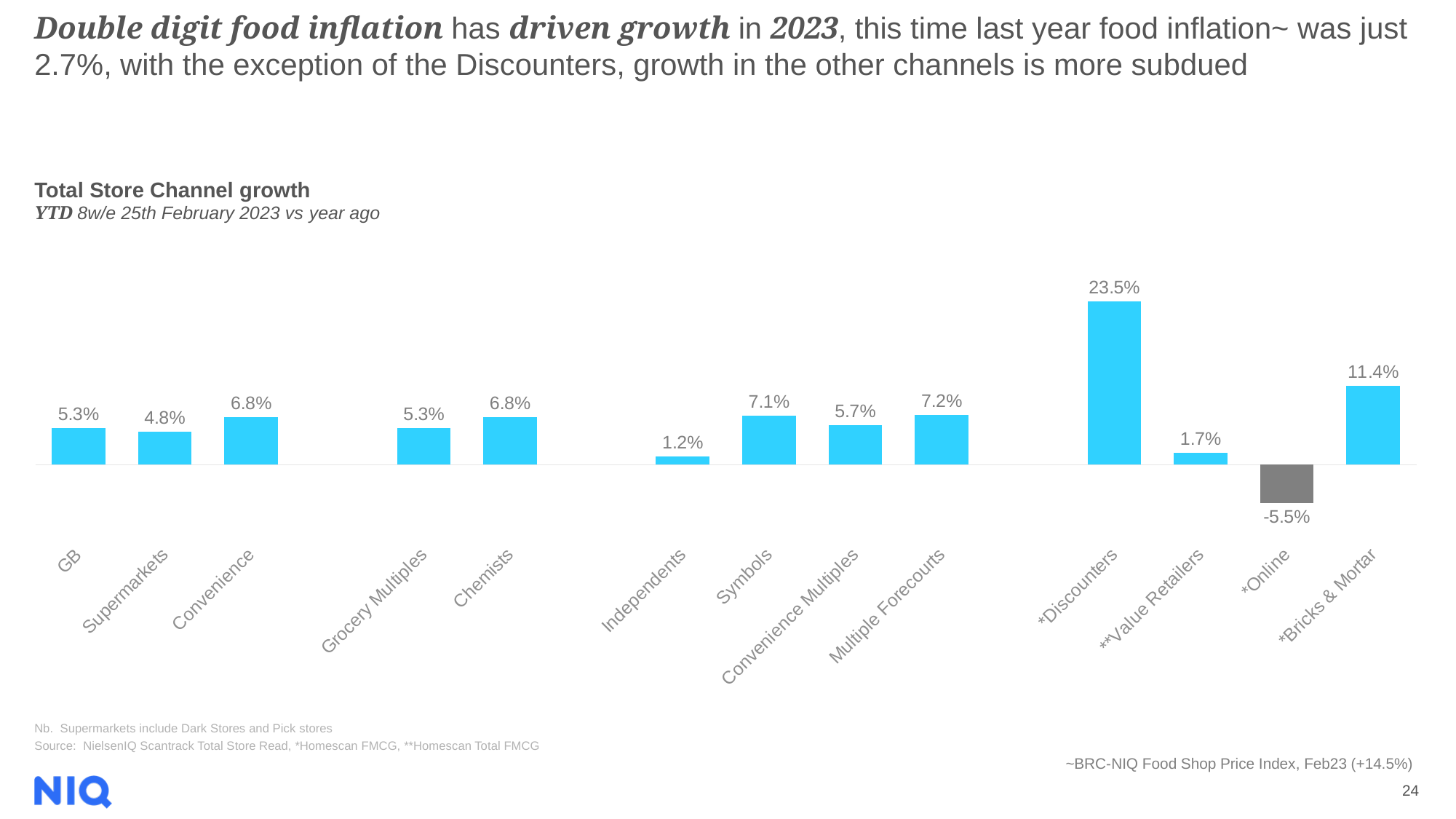
Which has the larger growth value, Symbols or Convenience Multiples? Symbols What is the Total Store Channel growth value for GB? 5.3% How many channels (bars) are shown on the chart? 14 Which channel has the highest growth value on the chart? *Discounters What is the growth value shown for *Discounters? 23.5% What kind of chart is shown on the slide? Bar chart Which channel has the lowest growth value on the chart? *Online What is the difference between the growth values for *Discounters and *Bricks & Mortar? 12.1% What is the growth value shown for *Online? -5.5% What is the growth value shown for Independents? 1.2% What is the difference between the growth values for Multiple Forecourts and Supermarkets? 2.4% What is the title of the chart? Total Store Channel growth